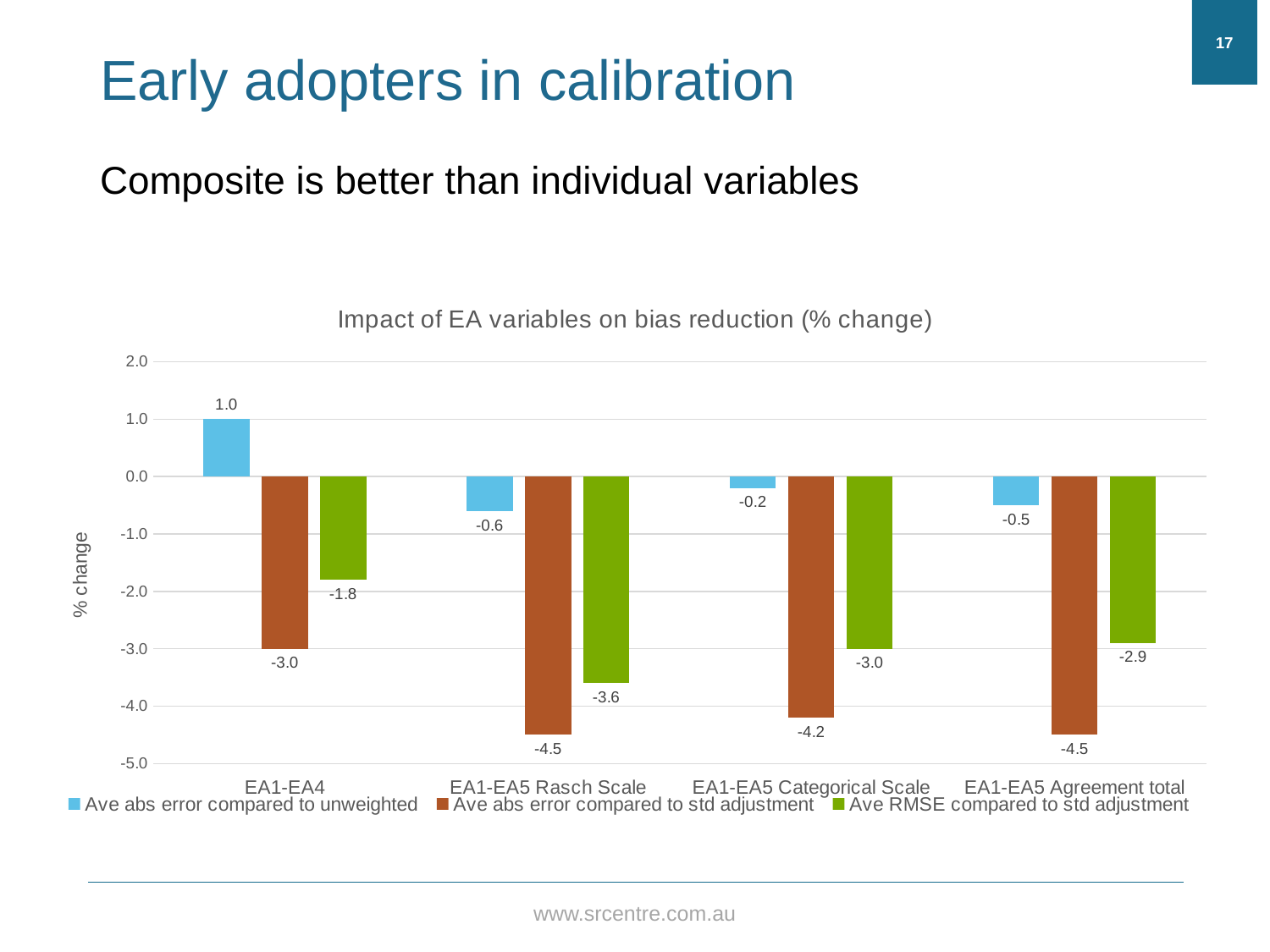
Which category has the lowest value for Ave RMSE compared to std adjustment? EA1-EA5 Rasch Scale For EA1-EA5 Categorical Scale, which is larger: Ave abs error compared to std adjustment or Ave RMSE compared to std adjustment? Ave RMSE compared to std adjustment What type of chart is shown on the slide? Bar chart What is the difference between Ave abs error compared to std adjustment and Ave RMSE compared to std adjustment for EA1-EA4? 1.2 What is the value of Ave abs error compared to unweighted for EA1-EA5 Agreement total? -0.5 What is the value of Ave RMSE compared to std adjustment for EA1-EA5 Categorical Scale? -3.0 Which category has the highest value for Ave abs error compared to std adjustment? EA1-EA4 How many categories are shown on the x axis? 4 Which category has the highest value for Ave abs error compared to unweighted? EA1-EA4 How many series does the legend list? 3 What is the value of Ave abs error compared to std adjustment for EA1-EA5 Rasch Scale? -4.5 What is the value of Ave abs error compared to unweighted for EA1-EA4? 1.0